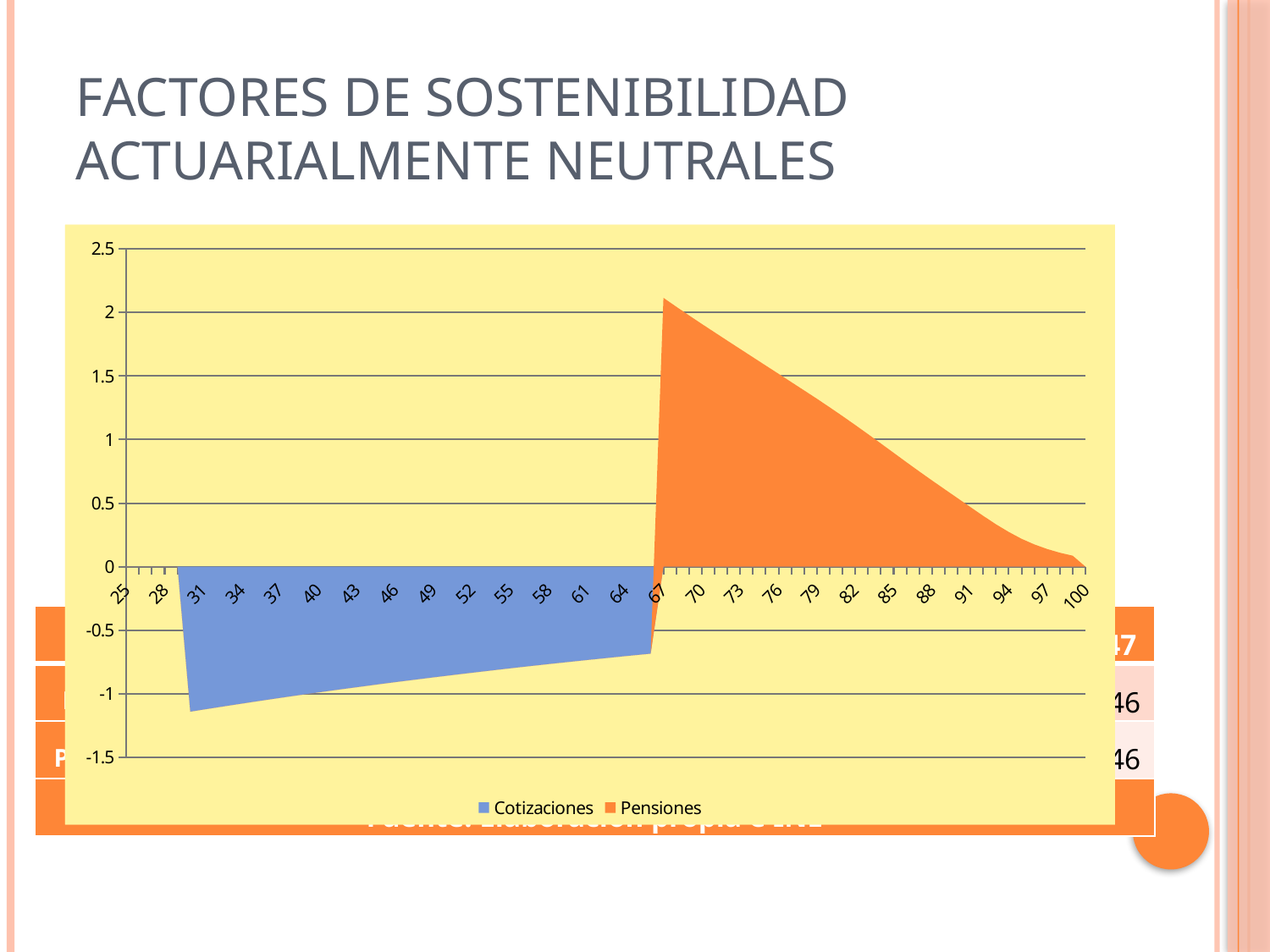
How many labels are shown on the x axis? 26 Is the value for Cotizaciones at 40 greater or less than -0.5? less Do the Pensiones values rise or fall as the x axis goes from 67 to 100? fall Is the value for Pensiones at 88 greater or less than 1? less Which series is shown in orange? Pensiones Which series is shown in blue? Cotizaciones Which series has values below zero, Cotizaciones or Pensiones? Cotizaciones What kind of chart is shown on the slide? Area chart Is the value for Pensiones at 70 greater or less than 1.5? greater How many series does the legend list? 2